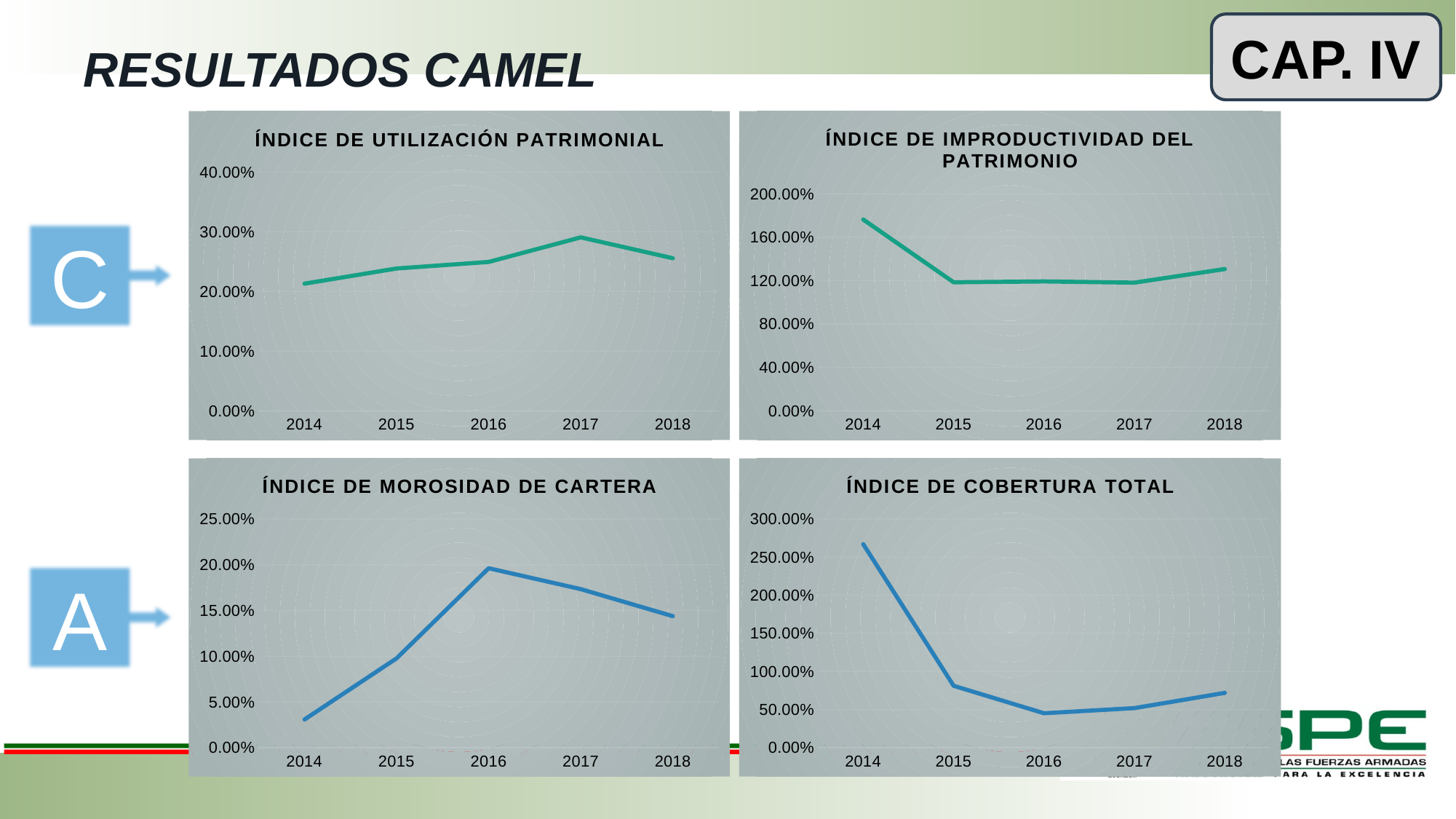
In the ÍNDICE DE MOROSIDAD DE CARTERA chart, which year has the highest value? 2016 In the ÍNDICE DE MOROSIDAD DE CARTERA chart, do the values rise or fall from 2014 to 2016? rise In the ÍNDICE DE UTILIZACIÓN PATRIMONIAL chart, which year has the highest value? 2017 How many years are plotted on the ÍNDICE DE MOROSIDAD DE CARTERA chart? 5 In the ÍNDICE DE COBERTURA TOTAL chart, is the value for 2015 larger or smaller than the value for 2018? larger In the ÍNDICE DE IMPRODUCTIVIDAD DEL PATRIMONIO chart, is the value for 2014 greater or less than 160.00%? greater What kind of chart is the ÍNDICE DE UTILIZACIÓN PATRIMONIAL chart? Line chart In the ÍNDICE DE COBERTURA TOTAL chart, which year has the lowest value? 2016 In the ÍNDICE DE COBERTURA TOTAL chart, is the value for 2014 greater or less than 250.00%? greater In the ÍNDICE DE IMPRODUCTIVIDAD DEL PATRIMONIO chart, which year has the highest value? 2014 In the ÍNDICE DE MOROSIDAD DE CARTERA chart, is the value for 2014 greater or less than 5.00%? less In the ÍNDICE DE UTILIZACIÓN PATRIMONIAL chart, which year has the lowest value? 2014